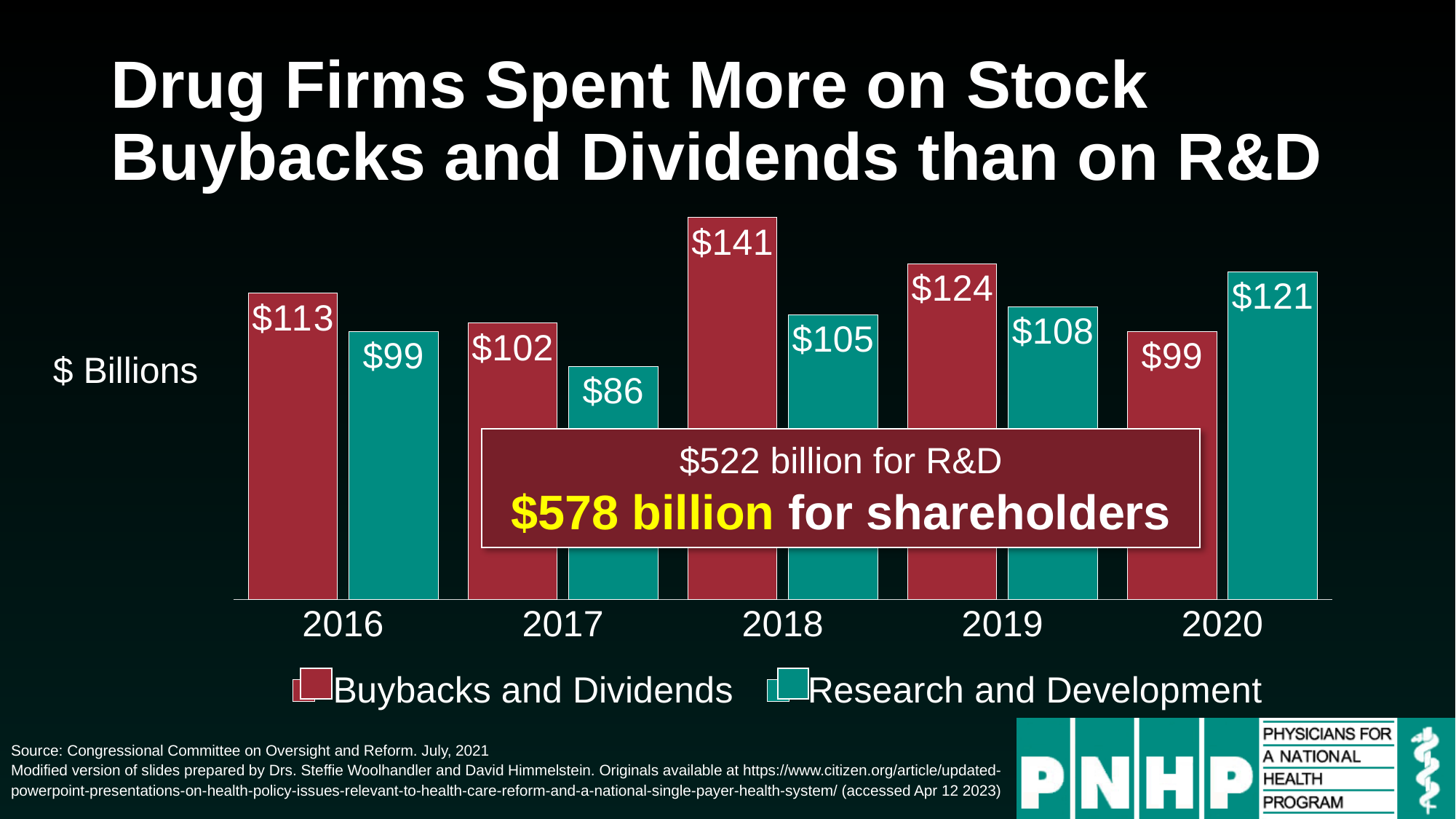
What was spent on Research and Development in 2020? $121 How many series does the legend list? 2 What kind of chart is shown on the slide? Bar chart What was spent on Research and Development in 2017? $86 What was spent on Buybacks and Dividends in 2018? $141 What unit is shown on the y axis label? $ Billions What is the difference between Buybacks and Dividends and Research and Development spending in 2018? $36 What is the total spending on R&D stated in the callout box? $522 billion In which year was spending on Buybacks and Dividends highest? 2018 In 2020, which was larger: Buybacks and Dividends or Research and Development? Research and Development How many years are shown on the x axis? 5 In which year was spending on Research and Development lowest? 2017